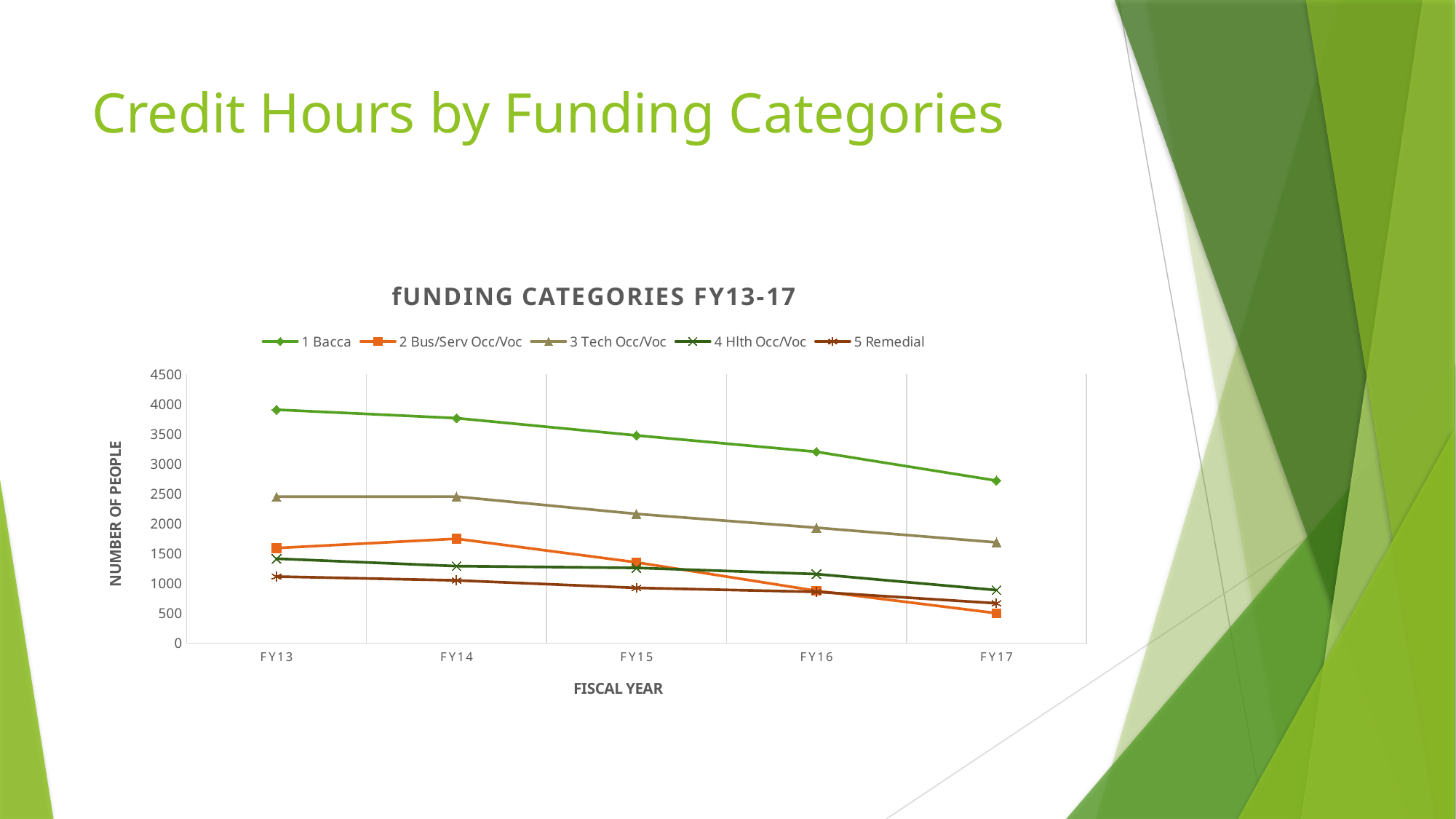
Is the value for 1 Bacca in FY17 greater or less than 3000? less What kind of chart is shown on the slide? line chart Which series has the highest value in FY17? 1 Bacca Which series has the lowest value in FY17? 2 Bus/Serv Occ/Voc Is the value for 1 Bacca in FY13 greater or less than 3500? greater Does the 1 Bacca series rise or fall from FY13 to FY17? fall Which is larger in FY14: 2 Bus/Serv Occ/Voc or 4 Hlth Occ/Voc? 2 Bus/Serv Occ/Voc Which series has the lowest value in FY13? 5 Remedial How many series does the legend list? 5 How many fiscal years are plotted on the x axis? 5 What is the label on the vertical axis of the chart? NUMBER OF PEOPLE Is the value for 2 Bus/Serv Occ/Voc in FY17 greater or less than 1000? less